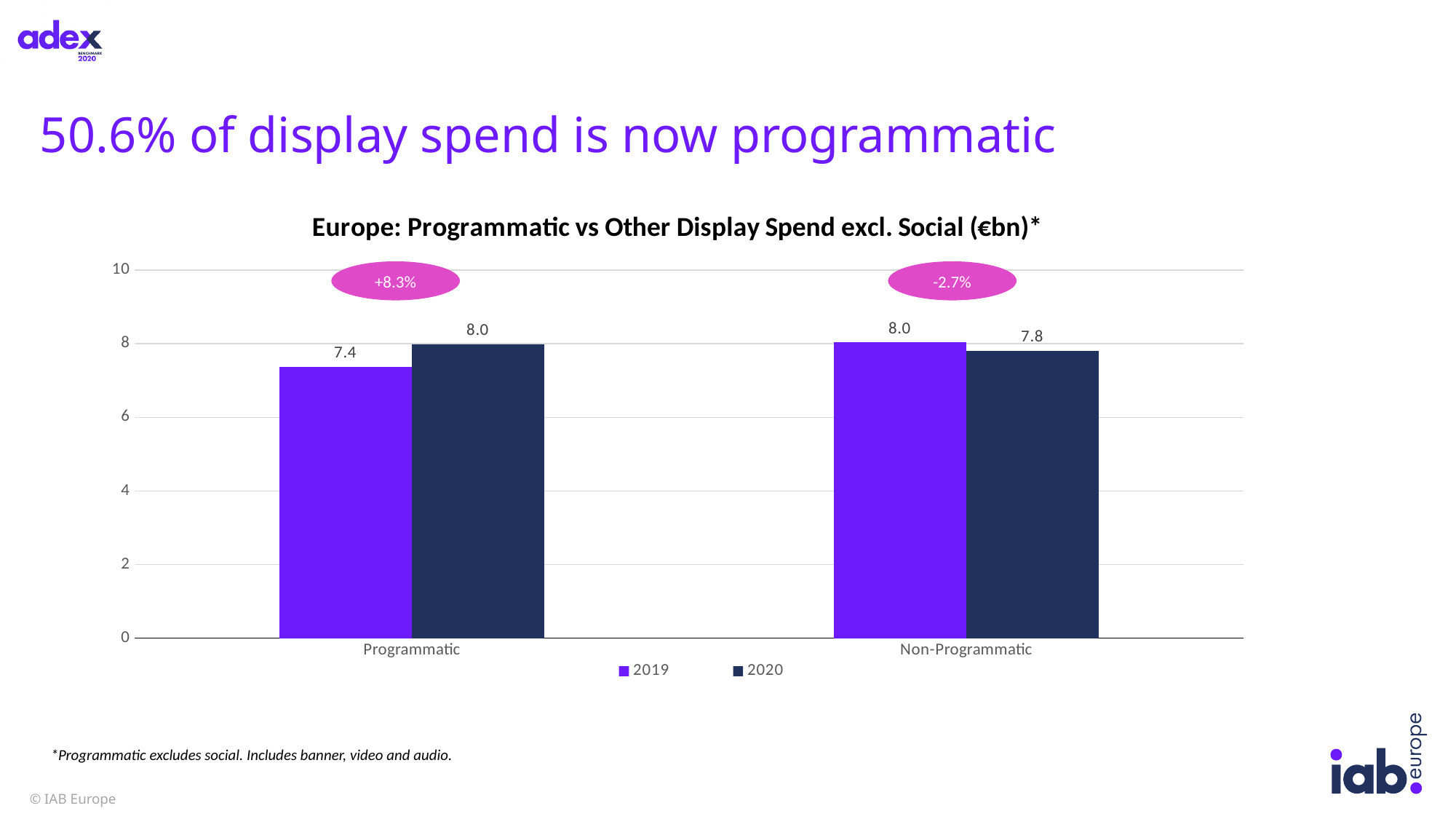
What percentage change is shown in the callout above the Programmatic bars? +8.3% How many categories are shown on the x axis? 2 What kind of chart is shown? Bar chart Which is larger for 2020: Programmatic or Non-Programmatic? Programmatic What is the difference between the 2019 and 2020 values for Non-Programmatic? 0.2 What is the 2020 value for Programmatic? 8.0 What is the 2020 value for Non-Programmatic? 7.8 What is the 2019 value for Programmatic? 7.4 What is the difference between the 2020 and 2019 values for Programmatic? 0.6 How many series does the legend list? 2 Which category has the lowest 2019 value? Programmatic What is the 2019 value for Non-Programmatic? 8.0